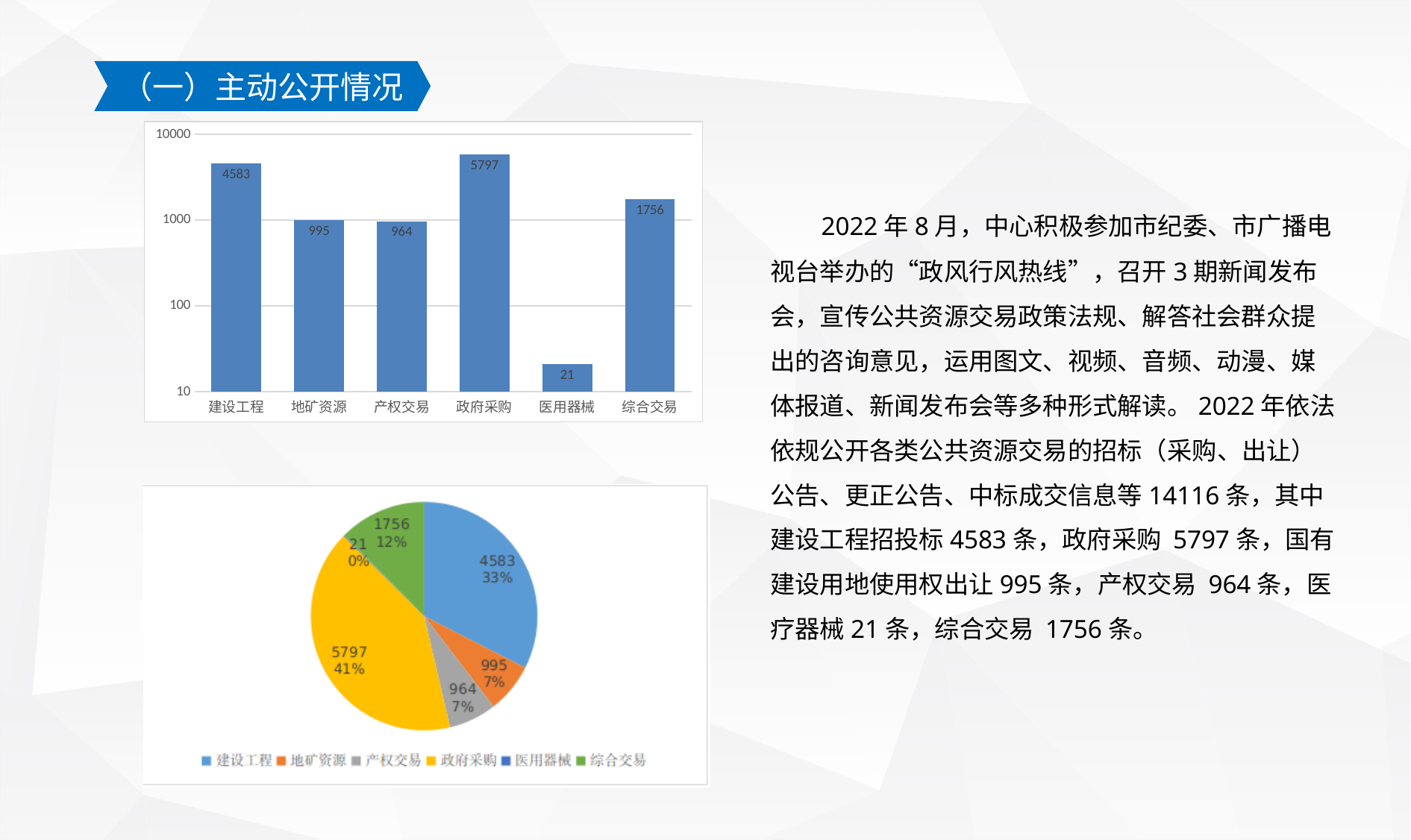
How many entries does the legend of the bottom pie chart list? 6 In the top bar chart, which is larger, the value for 综合交易 or the value for 地矿资源? 综合交易 In the top bar chart, which category has the highest value? 政府采购 What kind of chart is the top chart on the slide? bar chart In the top bar chart, what is the difference between the values for 政府采购 and 建设工程? 1214 In the bottom pie chart, what share does 综合交易 have? 12% How many categories are shown in the top bar chart? 6 In the top bar chart, what is the value for 政府采购? 5797 In the bottom pie chart, what colour is the slice for 建设工程? blue In the top bar chart, what is the value for 医用器械? 21 In the top bar chart, which category has the lowest value? 医用器械 In the bottom pie chart, what share does 政府采购 have? 41%